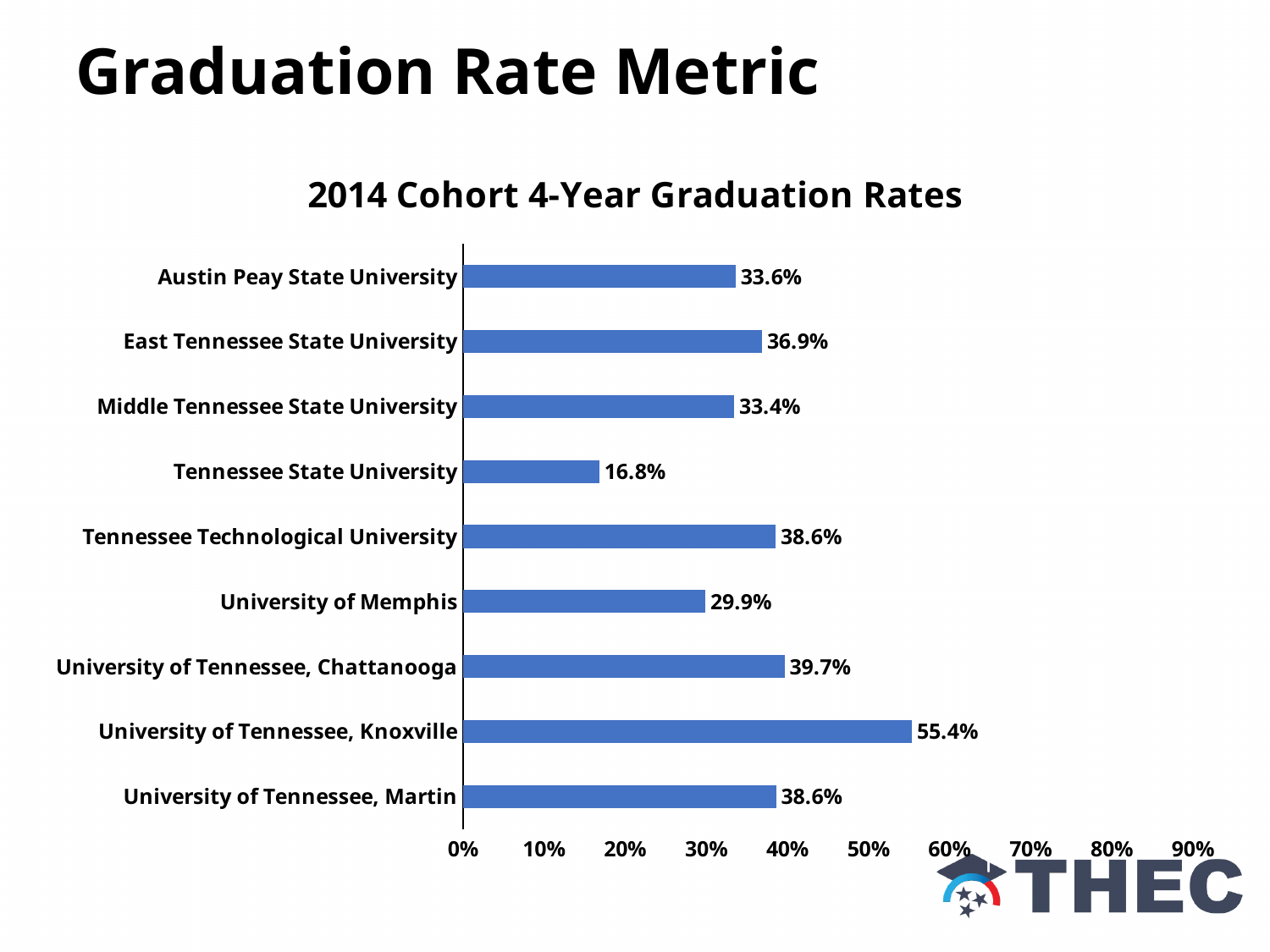
Is the value for University of Tennessee, Knoxville greater or less than 50%? greater What is the difference between the graduation rates of University of Tennessee, Knoxville and Tennessee State University? 38.6% What is the 4-year graduation rate for Tennessee State University? 16.8% What is the 4-year graduation rate for University of Memphis? 29.9% Which university has the highest 4-year graduation rate? University of Tennessee, Knoxville What is the 4-year graduation rate for University of Tennessee, Knoxville? 55.4% What kind of chart is shown on the slide? Bar chart What is the title of the chart? 2014 Cohort 4-Year Graduation Rates How many universities are shown in the chart? 9 Which university has the lowest 4-year graduation rate? Tennessee State University What is the difference between the graduation rates of East Tennessee State University and Austin Peay State University? 3.3% Which has a higher graduation rate, University of Tennessee, Chattanooga or University of Memphis? University of Tennessee, Chattanooga